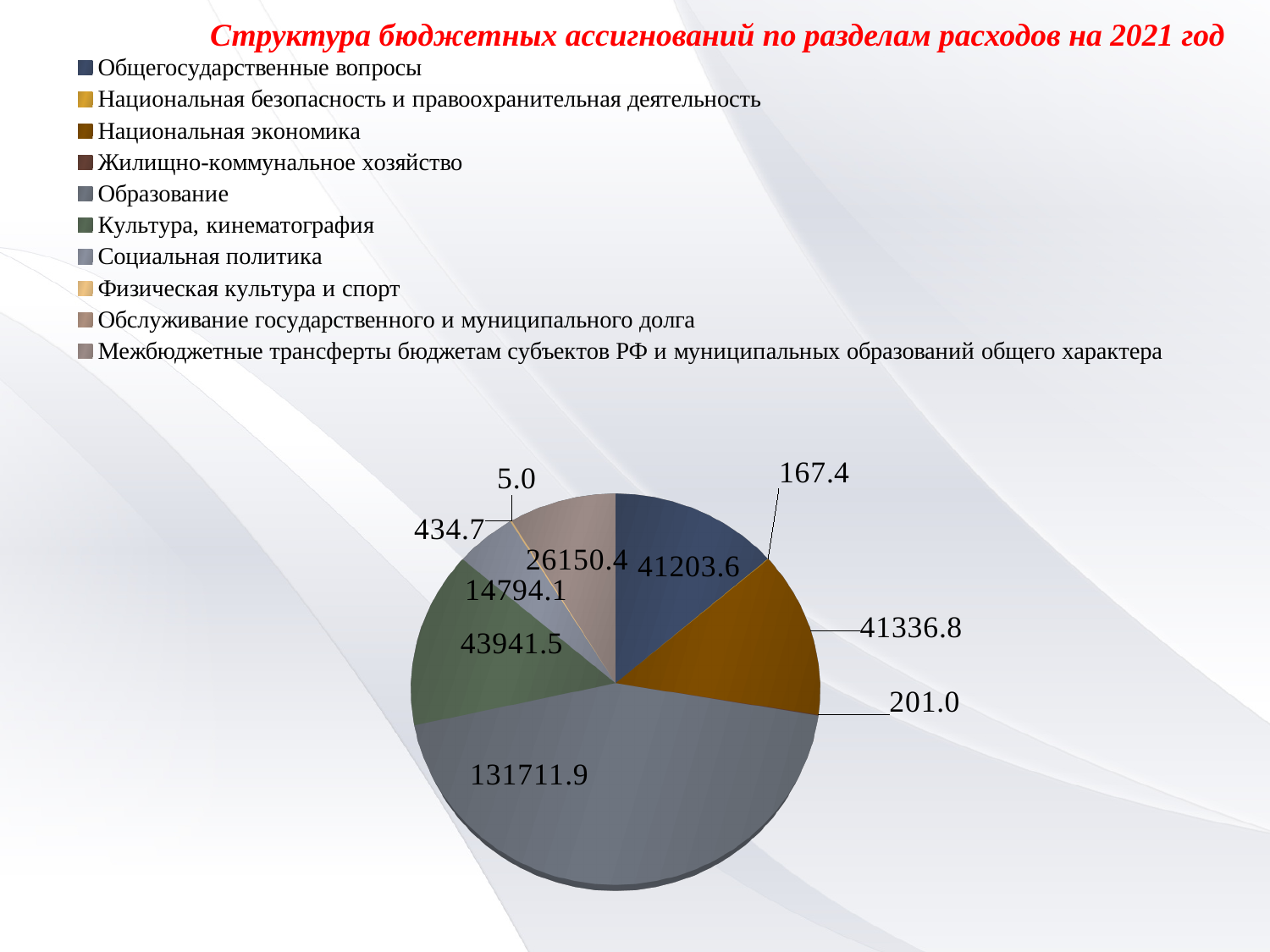
What is the difference between the values for Образование and Культура, кинематография? 87770.4 How many sections does the legend list? 10 Which section has the largest slice of the pie? Образование Which is larger, the value for Культура, кинематография or the value for Межбюджетные трансферты бюджетам субъектов РФ и муниципальных образований общего характера? Культура, кинематография What is the title of the chart? Структура бюджетных ассигнований по разделам расходов на 2021 год Which section has the smallest value? Обслуживание государственного и муниципального долга What is the value for Межбюджетные трансферты бюджетам субъектов РФ и муниципальных образований общего характера? 26150.4 What kind of chart is shown on the slide? pie chart What is the value for Образование? 131711.9 What is the value for Культура, кинематография? 43941.5 What is the value for Социальная политика? 14794.1 What is the value for Физическая культура и спорт? 434.7